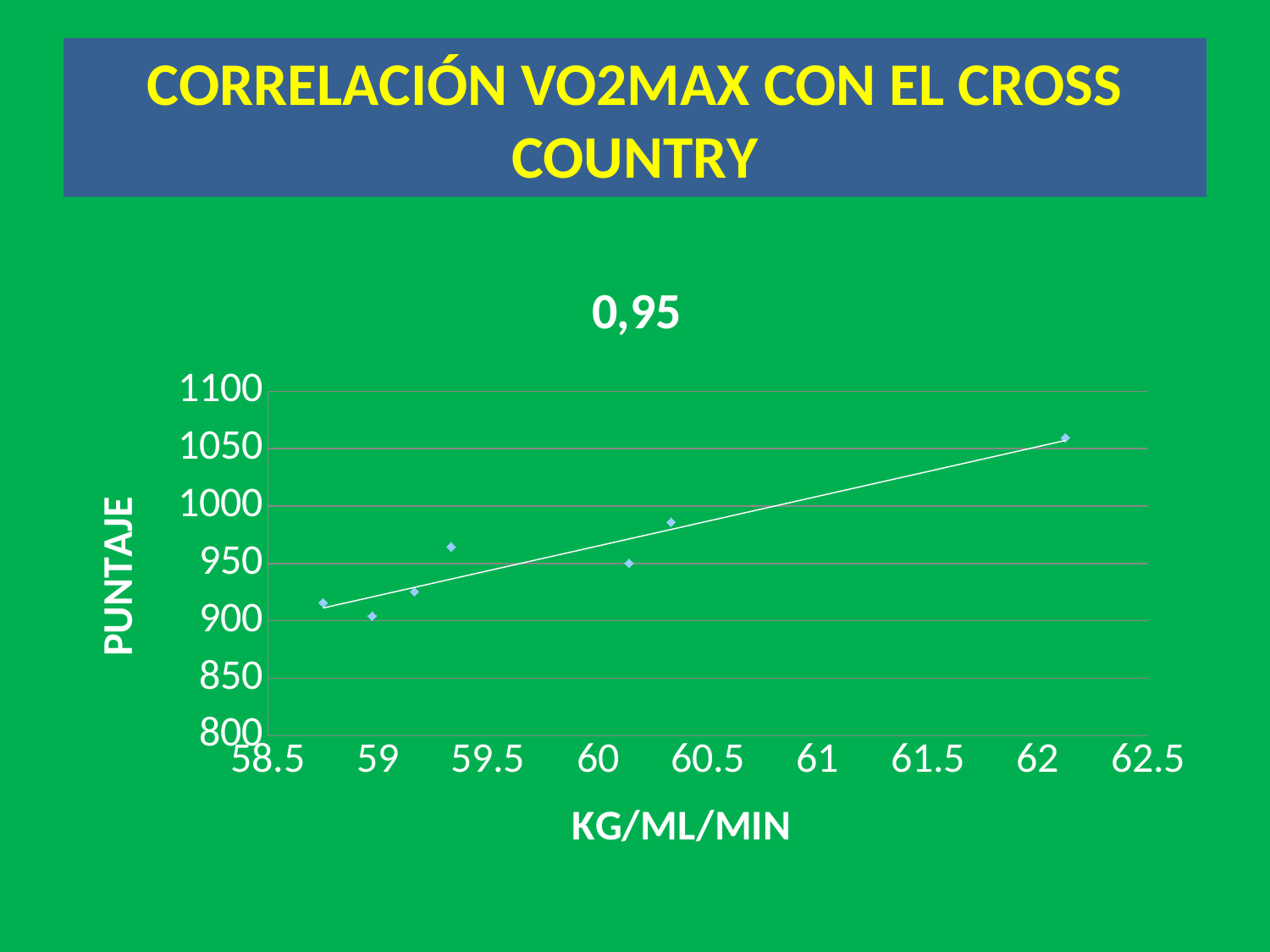
Is the PUNTAJE value of the point near 59 on the x axis greater or less than 950? less Is the PUNTAJE value of the point just above 60 on the x axis greater or less than 900? greater What is the title shown above the chart? 0,95 Which has the higher PUNTAJE: the point near 62 on the x axis or the point near 59? The point near 62 What is the label of the vertical axis? PUNTAJE Which x-axis tick is the point with the highest PUNTAJE closest to? 62 How many data points are plotted on the chart? 7 Is the PUNTAJE value of the point just below 60.5 on the x axis greater or less than 1000? less What kind of chart is shown on the slide? Scatter chart Do the plotted values generally rise or fall as KG/ML/MIN increases along the x axis? Rise What is the lowest value shown on the vertical axis? 800